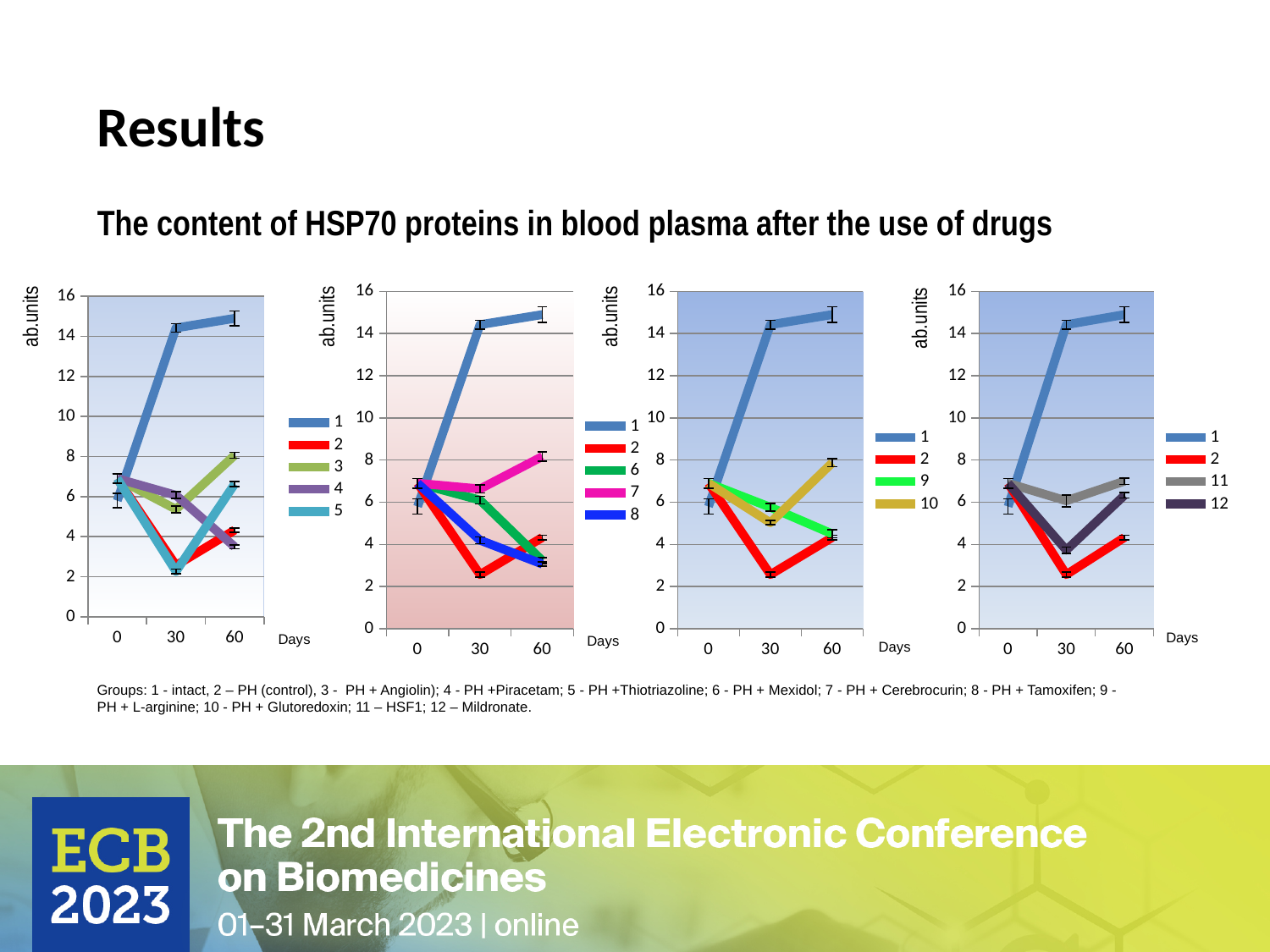
In the rightmost chart, does series 1 rise or fall from day 0 to day 60? rise In the leftmost chart, is the value for series 1 at day 60 greater or less than 12? greater What is the y-axis label on the charts? ab.units How many series does the legend of the second chart from the left list? 5 In the second chart from the left, which series has the lowest value at day 30? 2 How many series does the legend of the rightmost chart list? 4 In the leftmost chart, which series has the highest value at day 60? 1 How many series does the legend of the leftmost chart list? 5 How many time points are shown on the x axis of the third chart from the left? 3 In the leftmost chart, is the value for series 2 at day 30 greater or less than 4? less What kind of chart is the leftmost chart on the slide? Line chart In the third chart from the left, which is larger at day 60: series 9 or series 10? 10